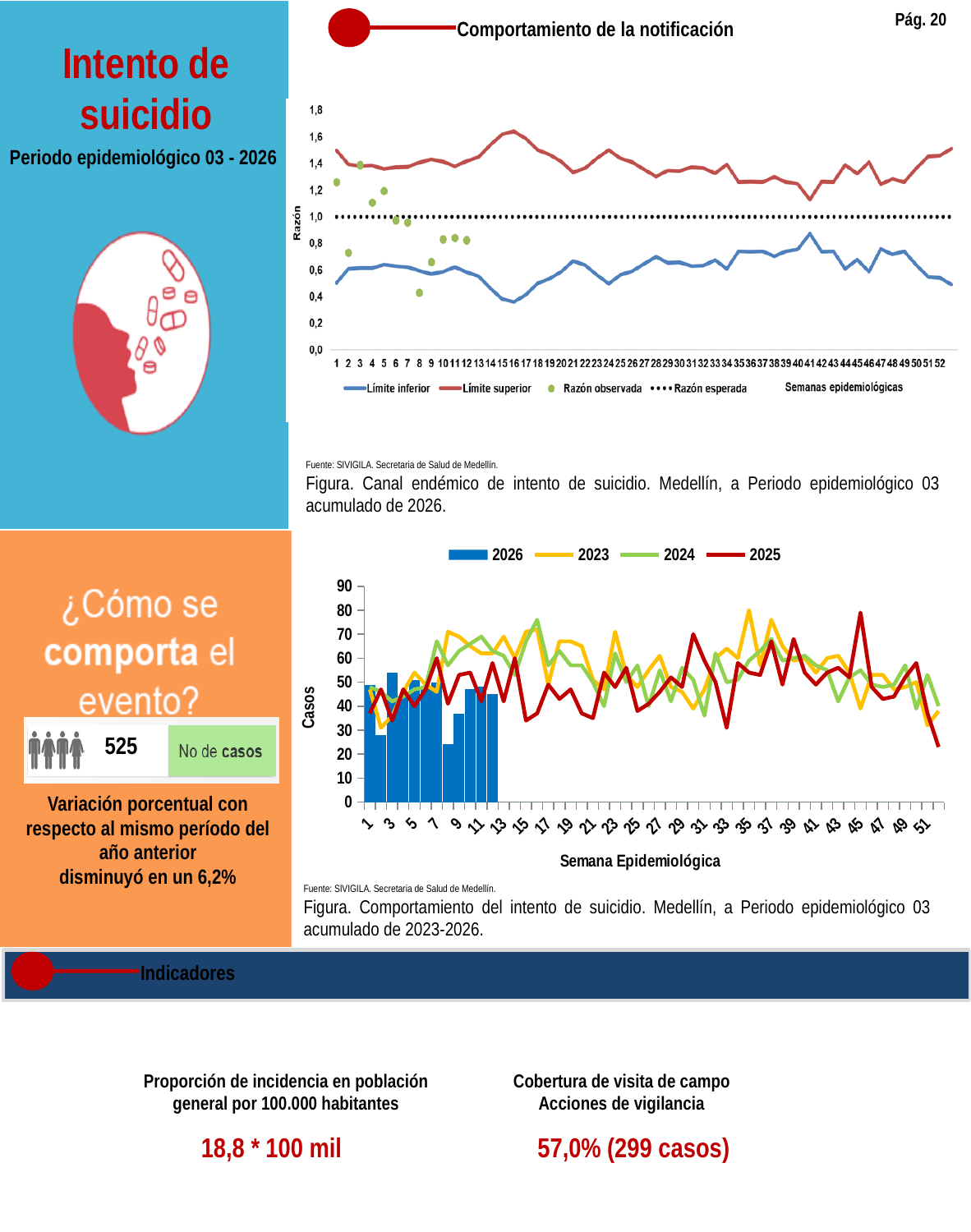
In the bottom chart (Comportamiento del intento de suicidio), does the 2025 line rise or fall from week 44 to week 52? Fall In the bottom chart (Comportamiento del intento de suicidio), which week has the lowest 2026 bar? Week 8 In the top chart (Canal endémico), is the Límite inferior value at week 16 greater or less than 0,6? less In the bottom chart (Comportamiento del intento de suicidio), is the 2026 bar at week 8 greater or less than 30? less In the top chart (Canal endémico), is the Límite superior value at week 16 greater or less than 1,4? greater In the top chart (Canal endémico), at what value on the Razón axis does the dotted Razón esperada line sit? 1,0 In the bottom chart (Comportamiento del intento de suicidio), which series is drawn as bars rather than a line? 2026 In the bottom chart (Comportamiento del intento de suicidio), which is larger: the 2026 bar at week 3 or the 2026 bar at week 8? Week 3 How many series does the legend of the top chart (Canal endémico) list? 4 How many series does the legend of the bottom chart (Comportamiento del intento de suicidio) list? 4